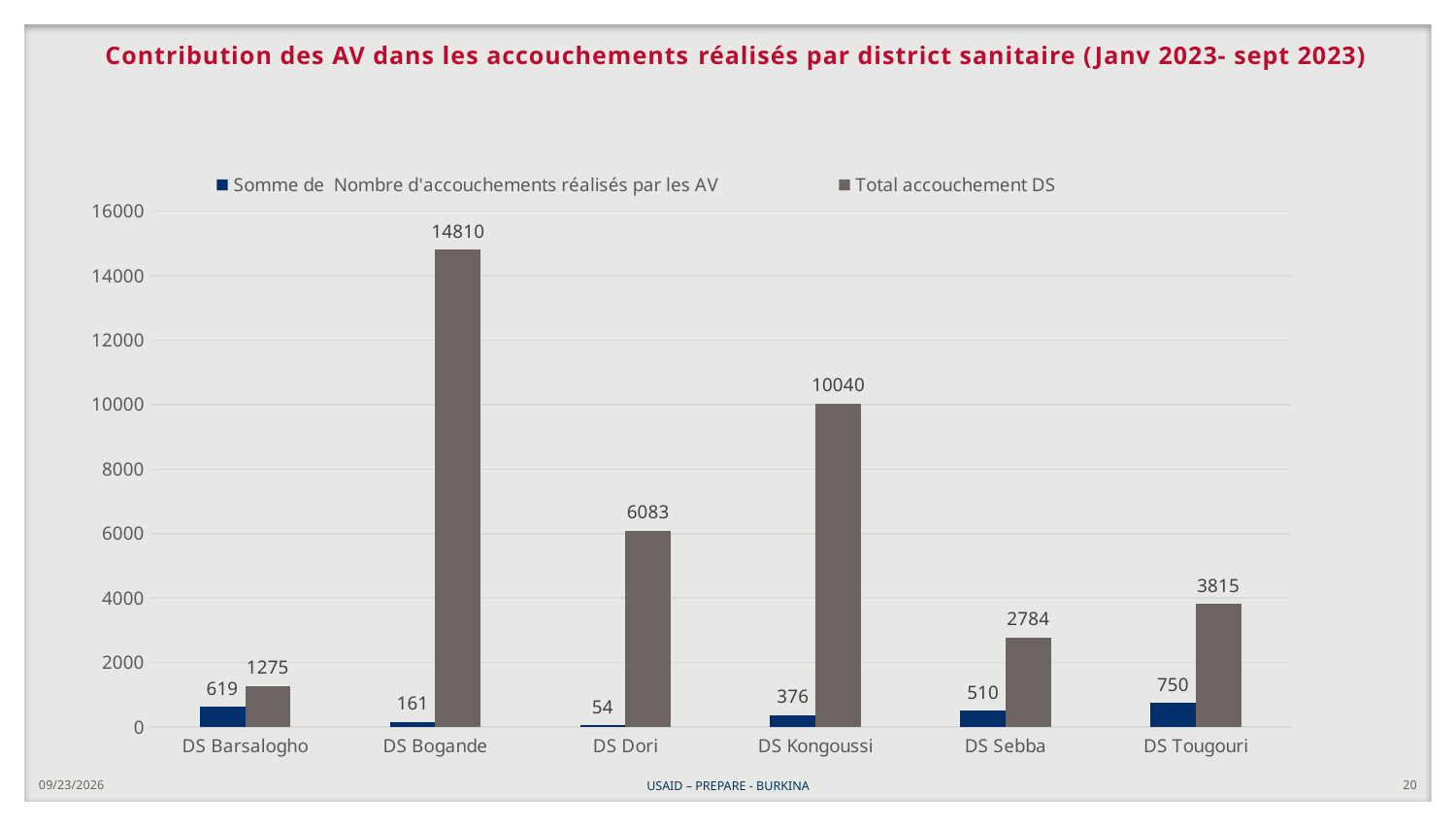
What is the difference between 'Total accouchement DS' and the AV deliveries for DS Tougouri? 3065 What is the title of the chart? Contribution des AV dans les accouchements réalisés par district sanitaire (Janv 2023- sept 2023) How many series does the legend list? 2 What is the value of 'Total accouchement DS' for DS Bogande? 14810 How many districts are shown on the x axis? 6 Which district has the lowest 'Somme de Nombre d'accouchements réalisés par les AV' value? DS Dori What kind of chart is shown on the slide? bar chart What is the value of 'Somme de Nombre d'accouchements réalisés par les AV' for DS Dori? 54 Which is larger: the AV deliveries for DS Barsalogho or for DS Tougouri? DS Tougouri Which district has the highest 'Total accouchement DS' value? DS Bogande Is the 'Total accouchement DS' value for DS Kongoussi greater or less than 8000? greater What is the value of 'Total accouchement DS' for DS Sebba? 2784